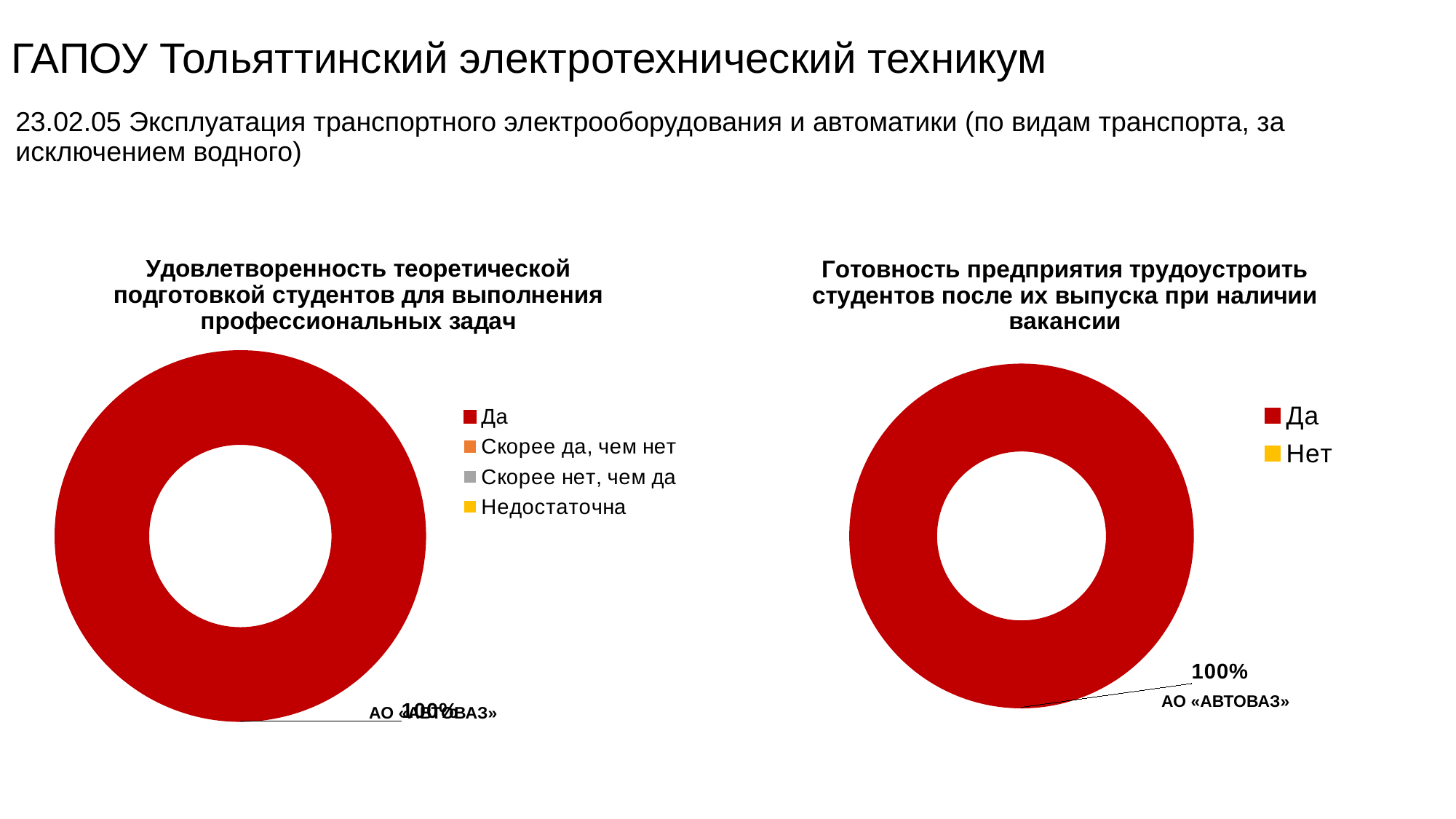
In the left chart ("Удовлетворенность теоретической подготовкой..."), which category has the largest share? Да What colour is the "Да" category in the legend of the right chart ("Готовность предприятия трудоустроить...")? Red In the left chart ("Удовлетворенность теоретической подготовкой..."), what is the data label shown for the "Да" slice? 100% In the left chart ("Удовлетворенность теоретической подготовкой..."), what share of the ring does the "Да" slice take? 100% In the right chart ("Готовность предприятия трудоустроить..."), which is larger, the share for "Да" or the share for "Нет"? Да Which enterprise is named in the data label of the right chart ("Готовность предприятия трудоустроить...")? АО «АВТОВАЗ» In the right chart ("Готовность предприятия трудоустроить..."), which category has the largest share? Да How many entries does the legend of the right chart ("Готовность предприятия трудоустроить...") list? 2 What kind of chart is the left chart, titled "Удовлетворенность теоретической подготовкой студентов для выполнения профессиональных задач"? Doughnut (pie) chart How many entries does the legend of the left chart ("Удовлетворенность теоретической подготовкой...") list? 4 What kind of chart is the right chart, titled "Готовность предприятия трудоустроить студентов после их выпуска при наличии вакансии"? Doughnut (pie) chart In the right chart ("Готовность предприятия трудоустроить..."), what share of the ring does the "Да" slice take? 100%